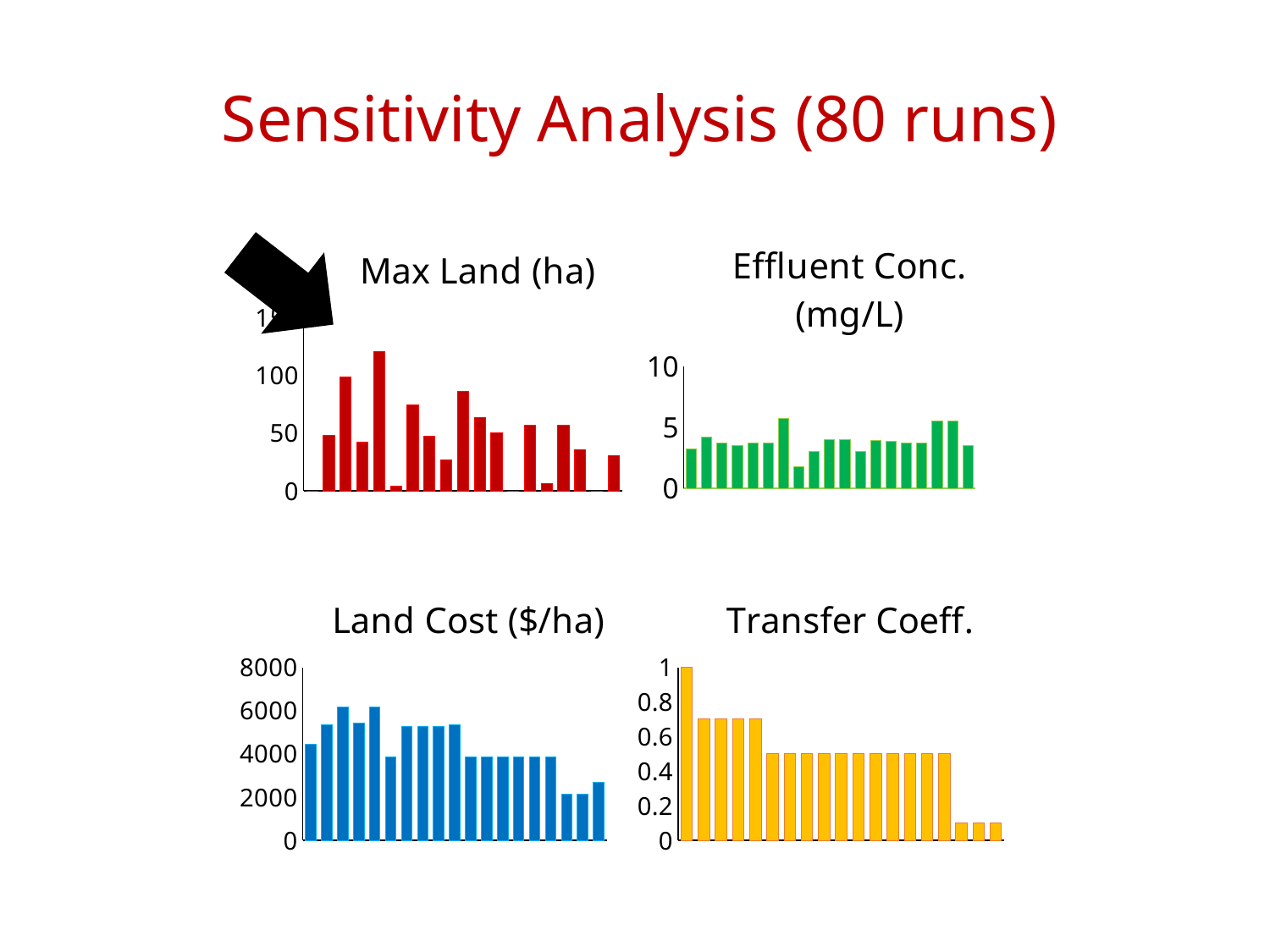
In the Transfer Coeff. chart, what is the value of the first (leftmost) bar? 1 What is the title of the slide? Sensitivity Analysis (80 runs) In the Max Land (ha) chart, is the tallest bar greater or less than 100? greater In the Transfer Coeff. chart, which is larger, the first bar or the last bar? the first bar In the Transfer Coeff. chart, do the values generally rise or fall from left to right? fall In the Transfer Coeff. chart, is the value of the last (rightmost) bar greater or less than 0.2? less In the Land Cost ($/ha) chart, is the first (leftmost) bar greater or less than 4000? greater In the Land Cost ($/ha) chart, do the values generally rise or fall from left to right? fall What type of chart is the Max Land (ha) chart? bar chart What colour are the bars in the Land Cost ($/ha) chart? blue